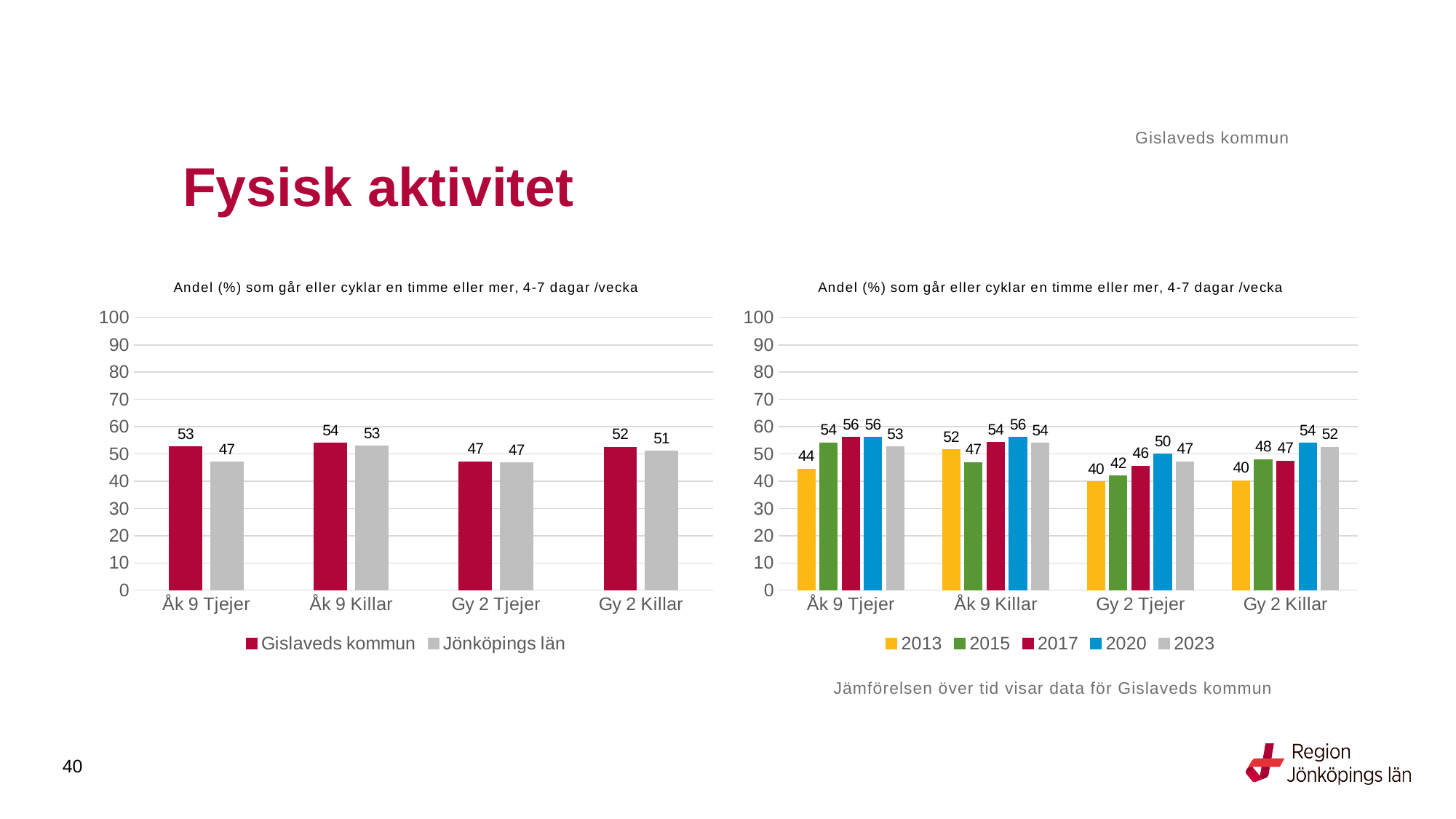
In the right chart, how many categories are shown on the x axis? 4 In the left chart, what is the value for Gislaveds kommun for Åk 9 Tjejer? 53 In the left chart, what is the difference between Gislaveds kommun and Jönköpings län for Åk 9 Tjejer? 6 In the right chart, how many series does the legend list? 5 In the left chart, what is the value for Jönköpings län for Gy 2 Killar? 51 In the right chart, what is the value for 2013 for Åk 9 Tjejer? 44 In the left chart, how many series does the legend list? 2 In the right chart, is the value for 2017 for Åk 9 Killar larger than the value for 2015 for Åk 9 Killar? Yes In the right chart, what is the value for 2020 for Gy 2 Killar? 54 In the left chart, which category has the highest value for Gislaveds kommun? Åk 9 Killar In the right chart, which category has the lowest value for 2023? Gy 2 Tjejer What kind of chart is the left chart? Bar chart